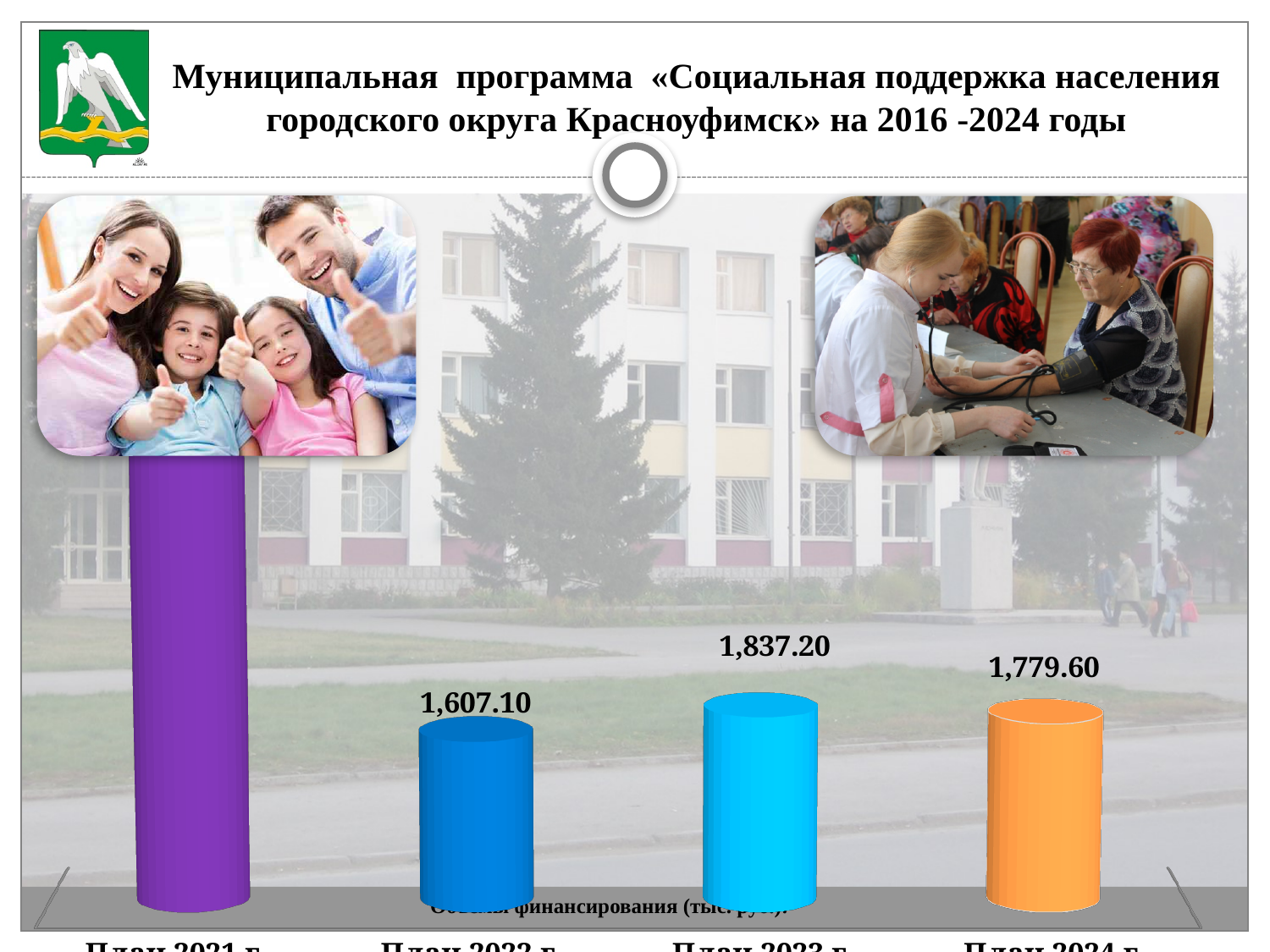
Does the value rise or fall from План 2022 г. to План 2023 г.? rise What is the value for План 2023 г.? 1,837.20 What is the difference between the values for План 2023 г. and План 2022 г.? 230.10 Which category has the lowest value? План 2022 г. Which category has the tallest bar? План 2021 г. How many categories are shown in the chart? 4 What kind of chart is shown on the slide? bar chart What is the value for План 2022 г.? 1,607.10 What is the difference between the values for План 2023 г. and План 2024 г.? 57.60 Which is larger, the value for План 2023 г. or План 2024 г.? План 2023 г. What colour is the bar for План 2021 г.? purple What is the value for План 2024 г.? 1,779.60